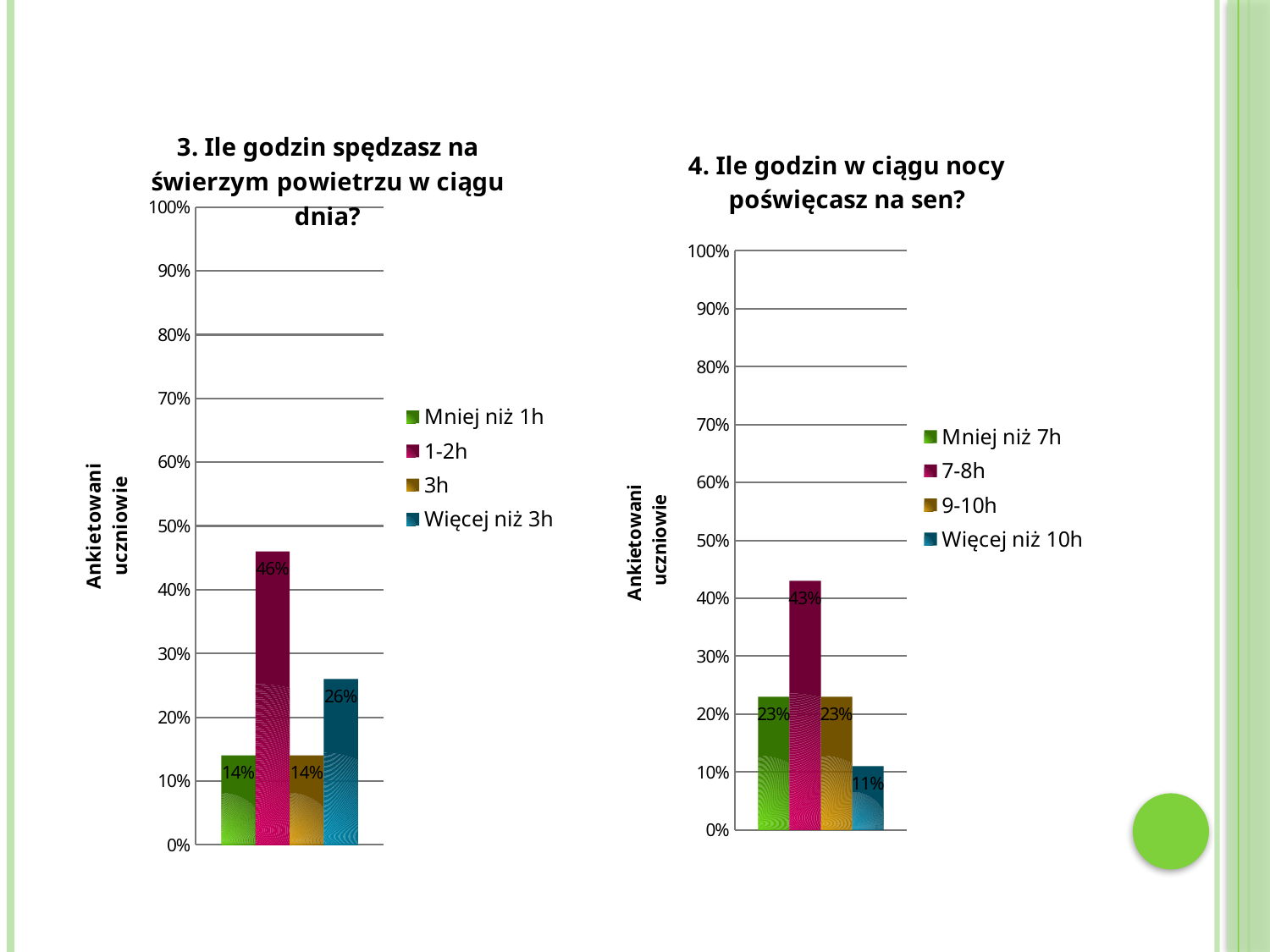
In the chart titled "3. Ile godzin spędzasz na świerzym powietrzu w ciągu dnia?", what is the value for Więcej niż 3h? 26% In the chart titled "4. Ile godzin w ciągu nocy poświęcasz na sen?", what is the value for 7-8h? 43% In the chart titled "4. Ile godzin w ciągu nocy poświęcasz na sen?", what is the value for Więcej niż 10h? 11% In the chart titled "4. Ile godzin w ciągu nocy poświęcasz na sen?", which is larger, the value for Mniej niż 7h or the value for Więcej niż 10h? Mniej niż 7h In the chart titled "4. Ile godzin w ciągu nocy poświęcasz na sen?", what is the difference between the values for 7-8h and 9-10h? 20% In the chart titled "3. Ile godzin spędzasz na świerzym powietrzu w ciągu dnia?", what is the difference between the values for 1-2h and Więcej niż 3h? 20% In the chart titled "3. Ile godzin spędzasz na świerzym powietrzu w ciągu dnia?", which series has the highest value? 1-2h In the chart titled "4. Ile godzin w ciągu nocy poświęcasz na sen?", which series has the lowest value? Więcej niż 10h In the chart titled "3. Ile godzin spędzasz na świerzym powietrzu w ciągu dnia?", what is the label of the vertical axis? Ankietowani uczniowie What kind of chart is the chart titled "4. Ile godzin w ciągu nocy poświęcasz na sen?"? bar chart In the chart titled "3. Ile godzin spędzasz na świerzym powietrzu w ciągu dnia?", how many series does the legend list? 4 In the chart titled "3. Ile godzin spędzasz na świerzym powietrzu w ciągu dnia?", what is the value for 1-2h? 46%